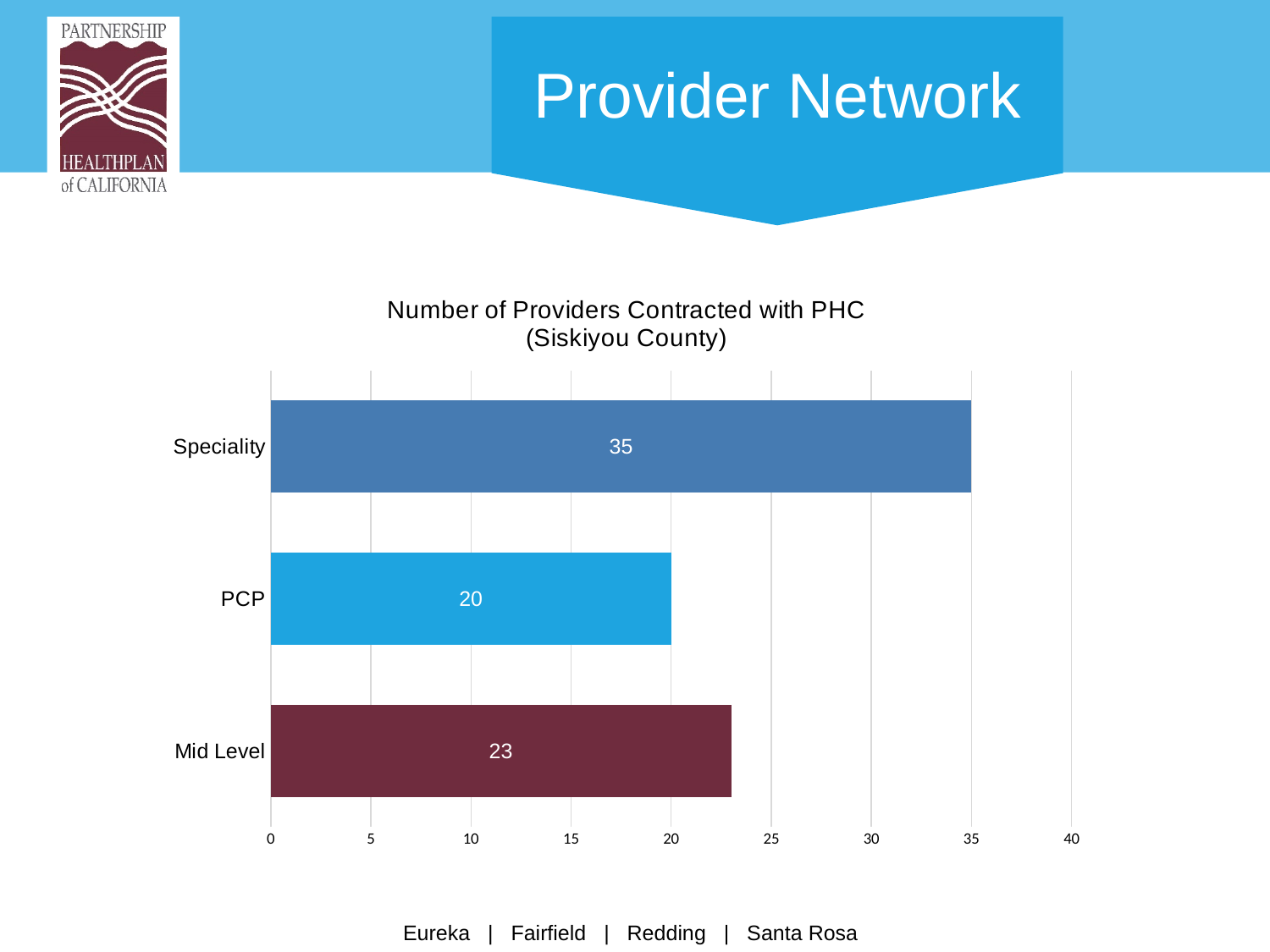
What kind of chart is shown on the slide? bar chart Which is larger, the value for Mid Level or the value for PCP? Mid Level How many providers are shown for Speciality? 35 What is the value for PCP? 20 What is the difference between the Speciality and PCP values? 15 What is the title of the chart? Number of Providers Contracted with PHC (Siskiyou County) What is the difference between the Mid Level and PCP values? 3 What is the value for Mid Level? 23 Which category has the lowest number of providers? PCP How many categories are shown in the chart? 3 Is the value for Speciality greater or less than 30? greater Which category has the highest number of providers? Speciality